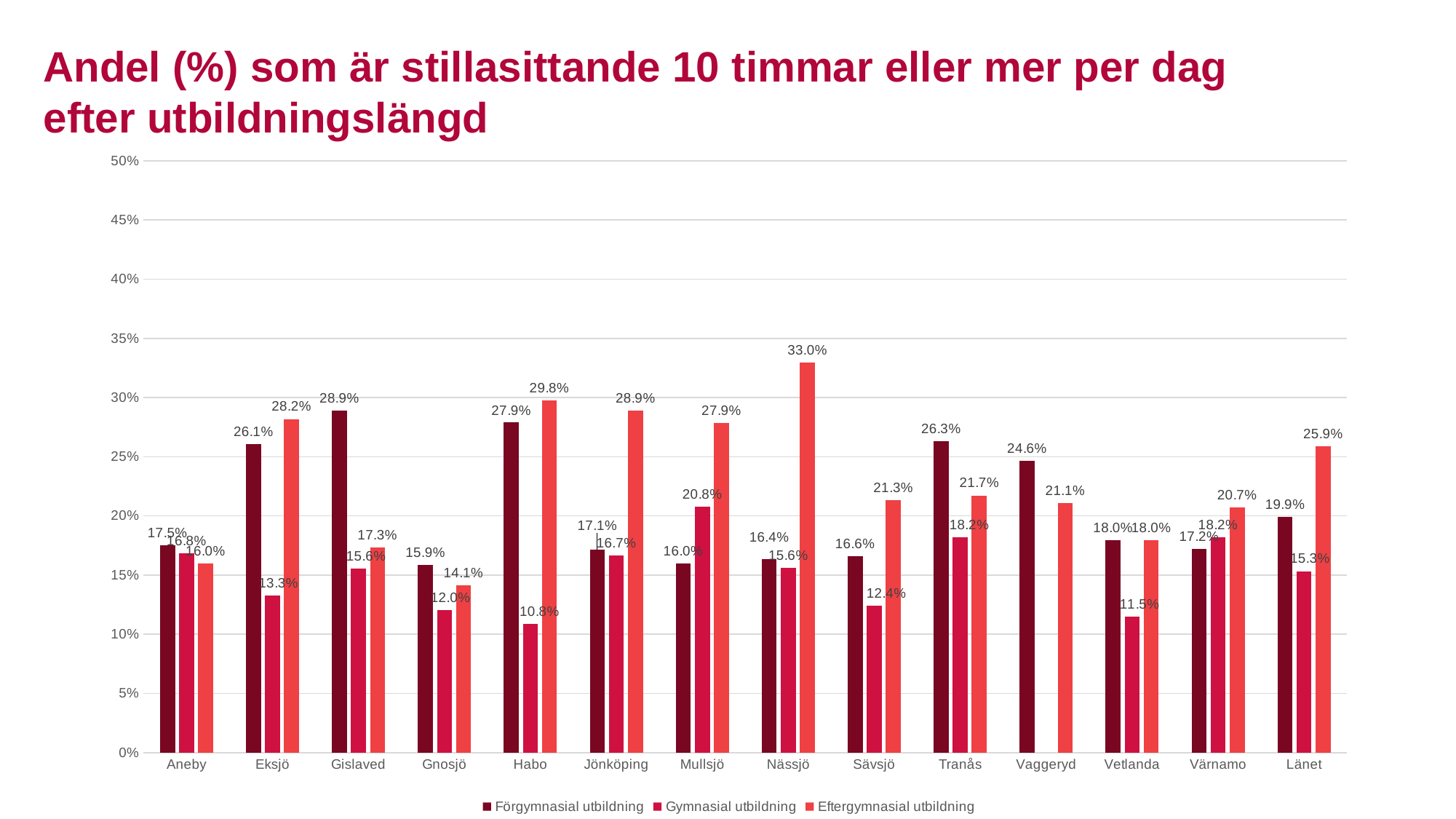
How many categories are shown on the x axis? 14 Which category has the highest value for Förgymnasial utbildning? Gislaved What is the difference between Eftergymnasial utbildning and Gymnasial utbildning in Länet? 10.6 percentage points What is the value for Eftergymnasial utbildning in Nässjö? 33.0% Which category has the highest value for Eftergymnasial utbildning? Nässjö What is the value for Förgymnasial utbildning in Länet? 19.9% How many series does the legend list? 3 Which series is shown in the darkest red colour in the legend? Förgymnasial utbildning In Tranås, which is larger: Förgymnasial utbildning or Eftergymnasial utbildning? Förgymnasial utbildning What is the difference between Eftergymnasial utbildning and Gymnasial utbildning in Habo? 19.0 percentage points Which category has the lowest value for Gymnasial utbildning? Habo What kind of chart is shown on the slide? Bar chart